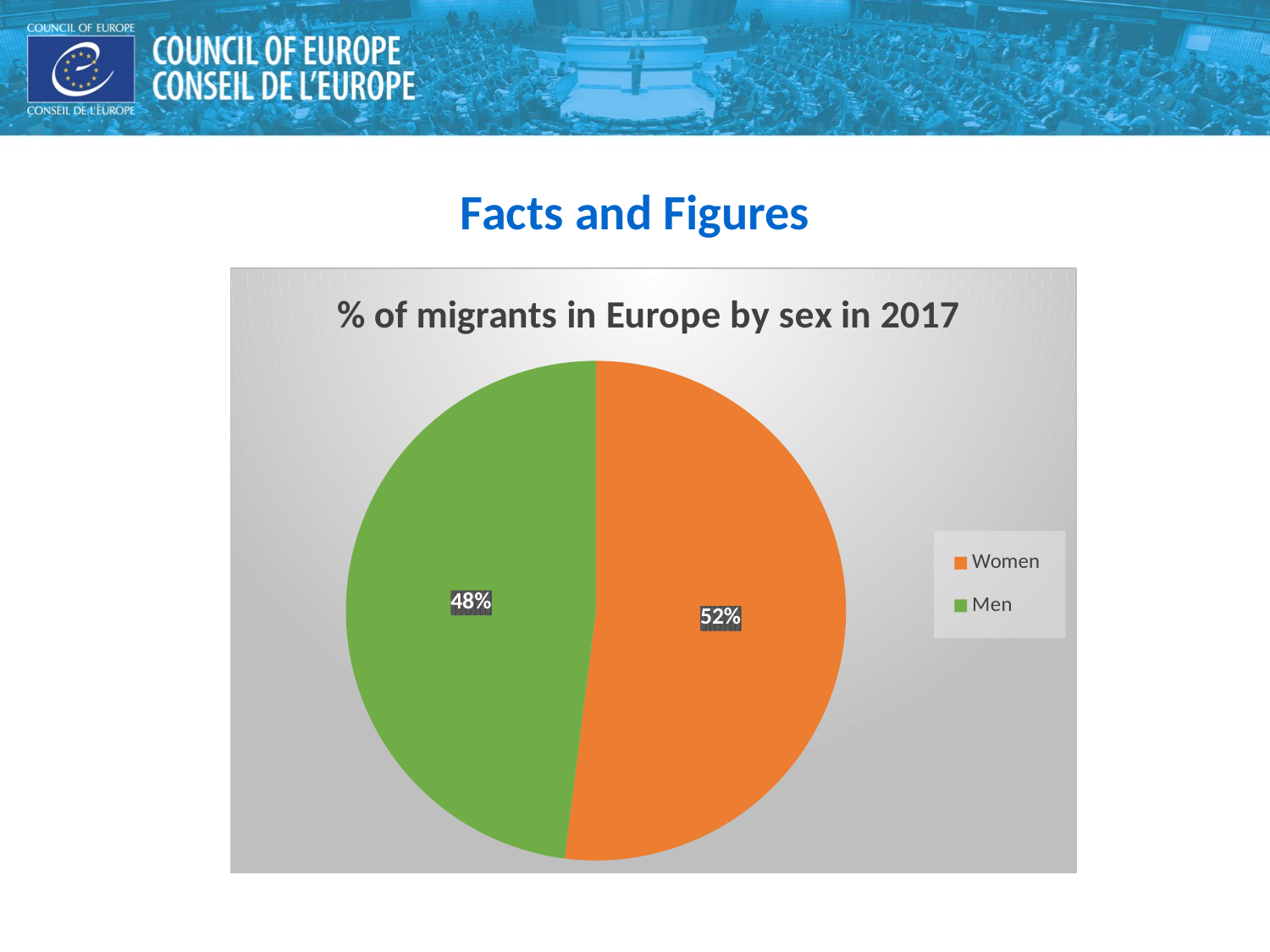
What percentage of migrants in Europe in 2017 were women? 52% Which category has the smaller share of the pie? Men What is the title of the chart? % of migrants in Europe by sex in 2017 How many slices does the pie chart have? 2 What percentage of migrants in Europe in 2017 were men? 48% How many categories does the legend list? 2 Is the share for Women larger or smaller than the share for Men? larger What type of chart is shown on the slide? pie chart What share of the pie does the Women slice represent? 52% What is the difference in percentage points between the Women and Men slices? 4 Which colour represents Men in the pie chart? green Which category has the larger share of the pie? Women